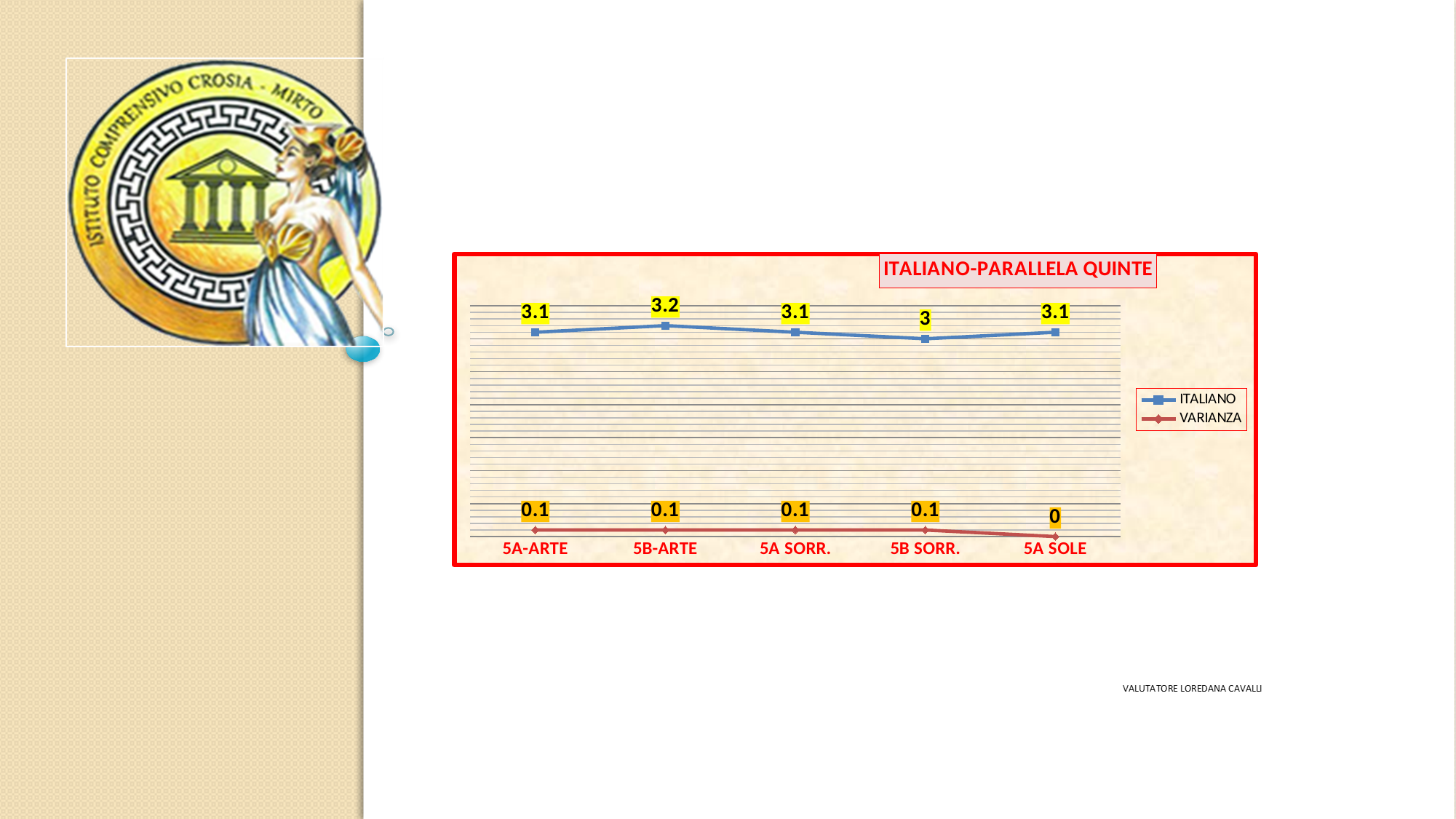
How many series does the legend list? 2 Which is larger, the ITALIANO value for 5A-ARTE or for 5B SORR.? 5A-ARTE What is the difference between the ITALIANO values for 5B-ARTE and 5B SORR.? 0.2 What is the VARIANZA value for 5A-ARTE? 0.1 Which category has the highest ITALIANO value? 5B-ARTE What is the ITALIANO value for 5B-ARTE? 3.2 What is the VARIANZA value for 5A SOLE? 0 How many categories are shown on the x axis? 5 What is the ITALIANO value for 5B SORR.? 3 What type of chart is shown? Line chart Which category has the lowest ITALIANO value? 5B SORR. Which category has the lowest VARIANZA value? 5A SOLE